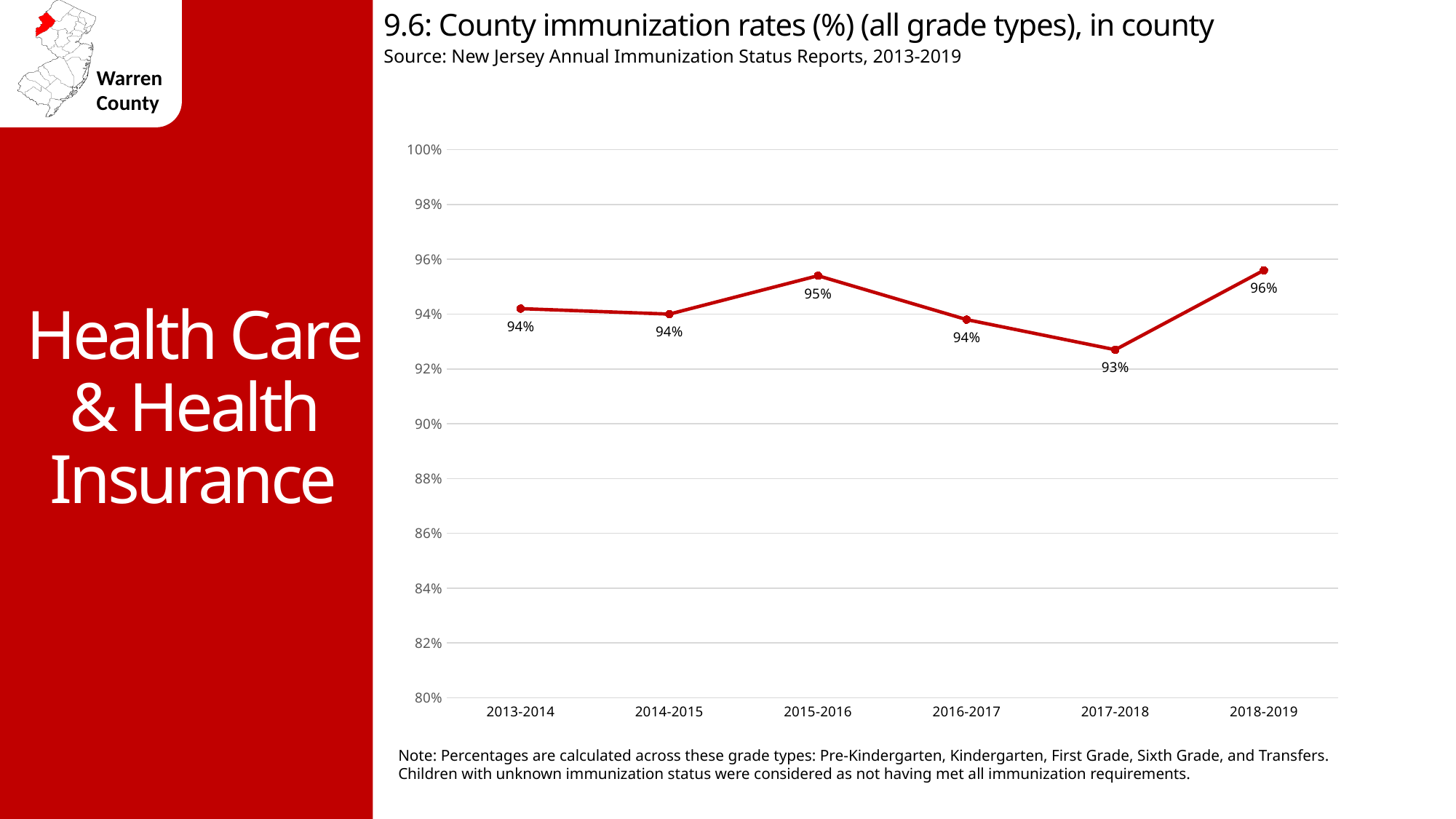
Is the value for 2017-2018 greater or less than 94%? less What is the difference between the immunization rate in 2018-2019 and in 2017-2018? 3 percentage points What is the county immunization rate for 2013-2014? 94% How many school years are plotted on the chart? 6 What is the county immunization rate for 2017-2018? 93% Which school year has the highest immunization rate? 2018-2019 What is the county immunization rate for 2018-2019? 96% Does the immunization rate rise or fall from 2017-2018 to 2018-2019? Rise Which is larger, the immunization rate in 2015-2016 or in 2017-2018? 2015-2016 What kind of chart is shown on the slide? Line chart Which school year has the lowest immunization rate? 2017-2018 What is the county immunization rate for 2015-2016? 95%